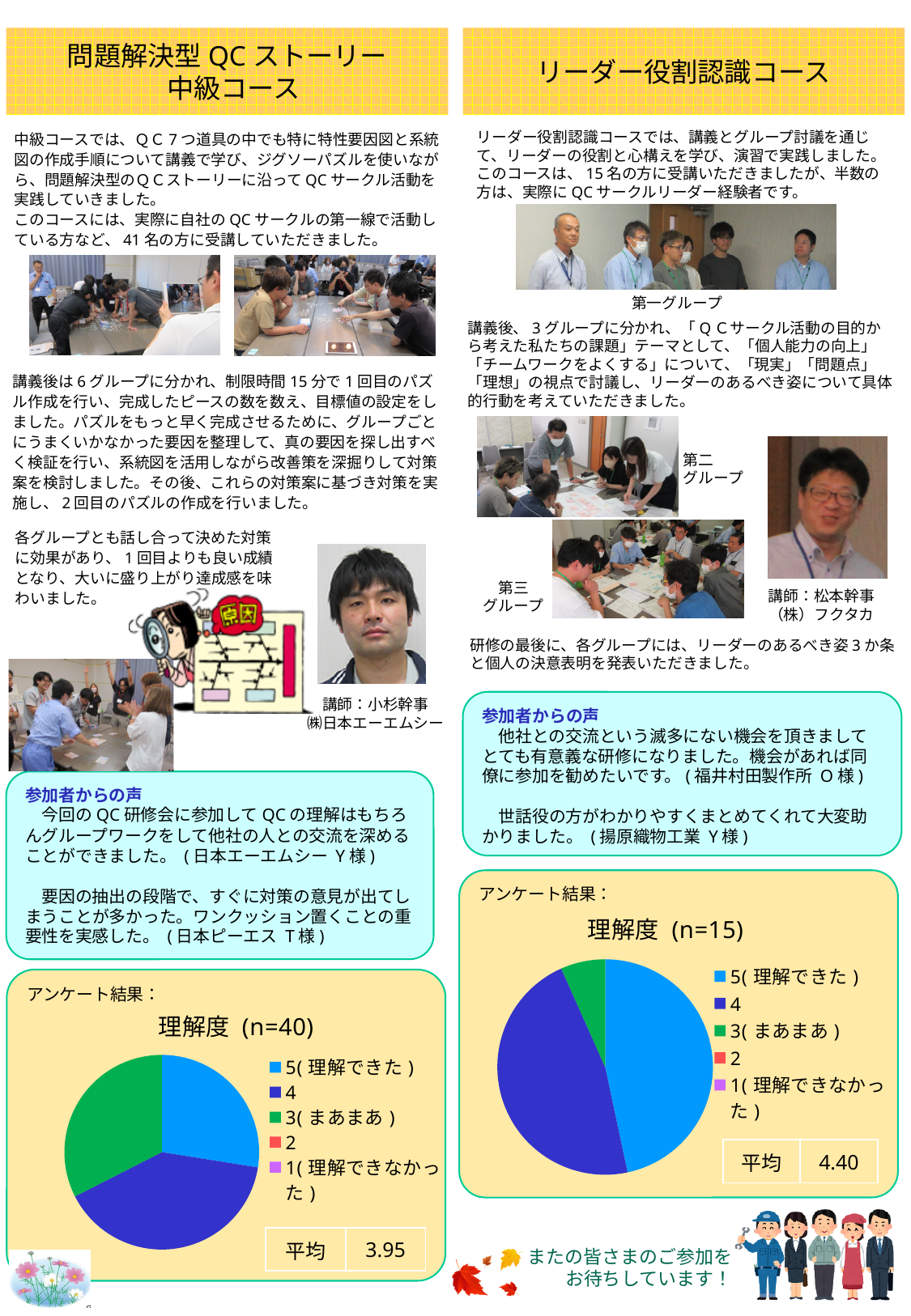
In the 理解度 (n=40) chart, which category has the largest slice? 4 What is the 平均 (average) shown below the 理解度 (n=15) chart? 4.40 What kind of chart is the 理解度 (n=15) chart on the right? pie chart In the 理解度 (n=15) chart, which slice is larger: 5(理解できた) or 3(まあまあ)? 5(理解できた) What kind of chart is the 理解度 (n=40) chart on the left? pie chart What is the 平均 (average) shown below the 理解度 (n=40) chart? 3.95 What is the title of the pie chart on the left side of the slide? 理解度 (n=40) How many entries does the legend of the 理解度 (n=40) chart list? 5 How many entries does the legend of the 理解度 (n=15) chart list? 5 In the 理解度 (n=15) chart, what colour is the slice for 3(まあまあ)? green